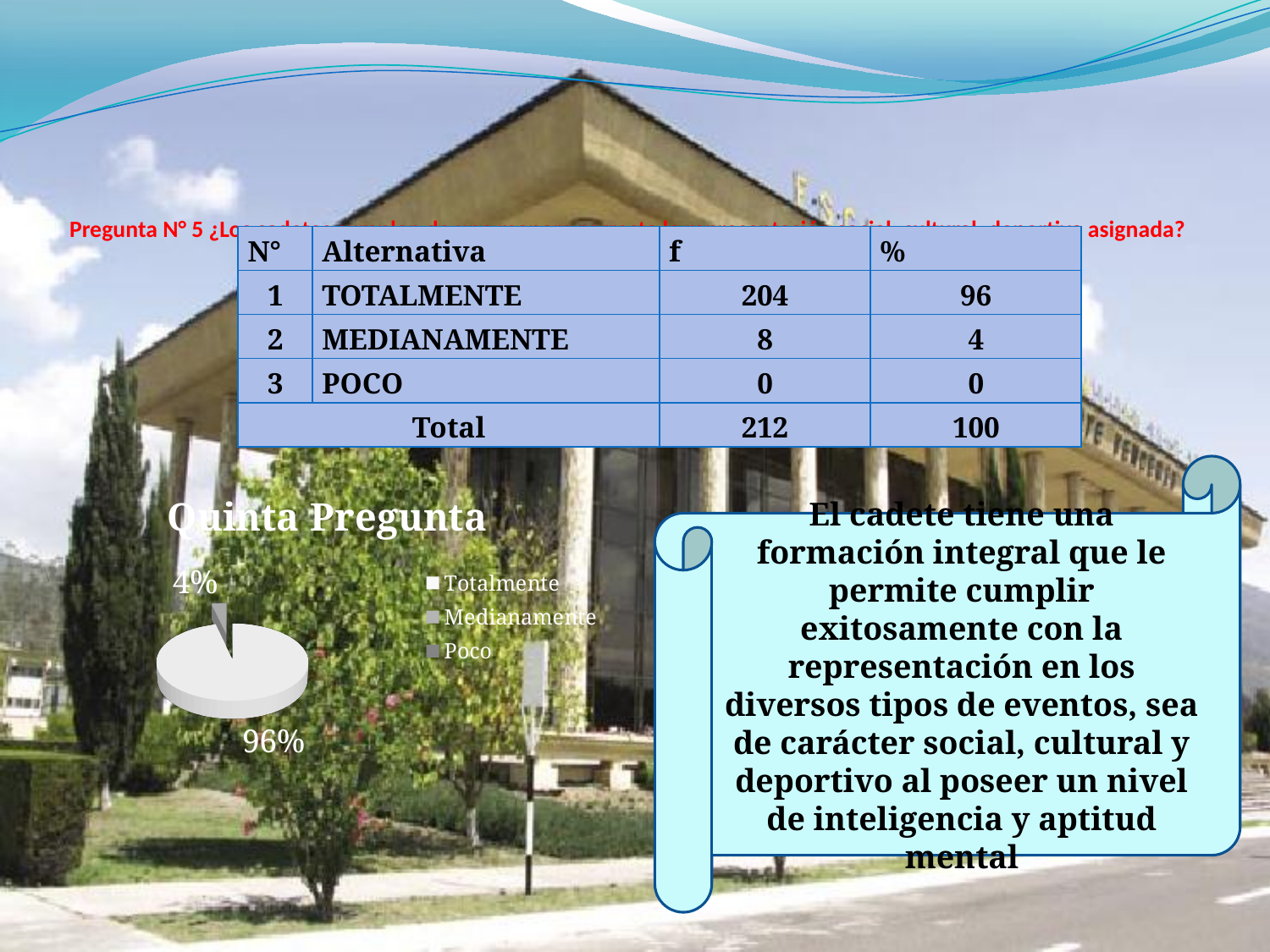
What is the difference in percentage points between the Totalmente slice and the Medianamente slice? 92 What are the three legend entries of the chart? Totalmente, Medianamente, Poco How many entries does the chart's legend list? 3 How many percentage data labels are printed on the pie chart? 2 What share of the pie does the Totalmente slice represent? 96% Which category has the largest slice of the pie? Totalmente What kind of chart is shown on the slide? pie chart What share of the pie does the Medianamente slice represent? 4% Which is larger, the Totalmente slice or the Medianamente slice? Totalmente What is the title of the chart? Quinta Pregunta